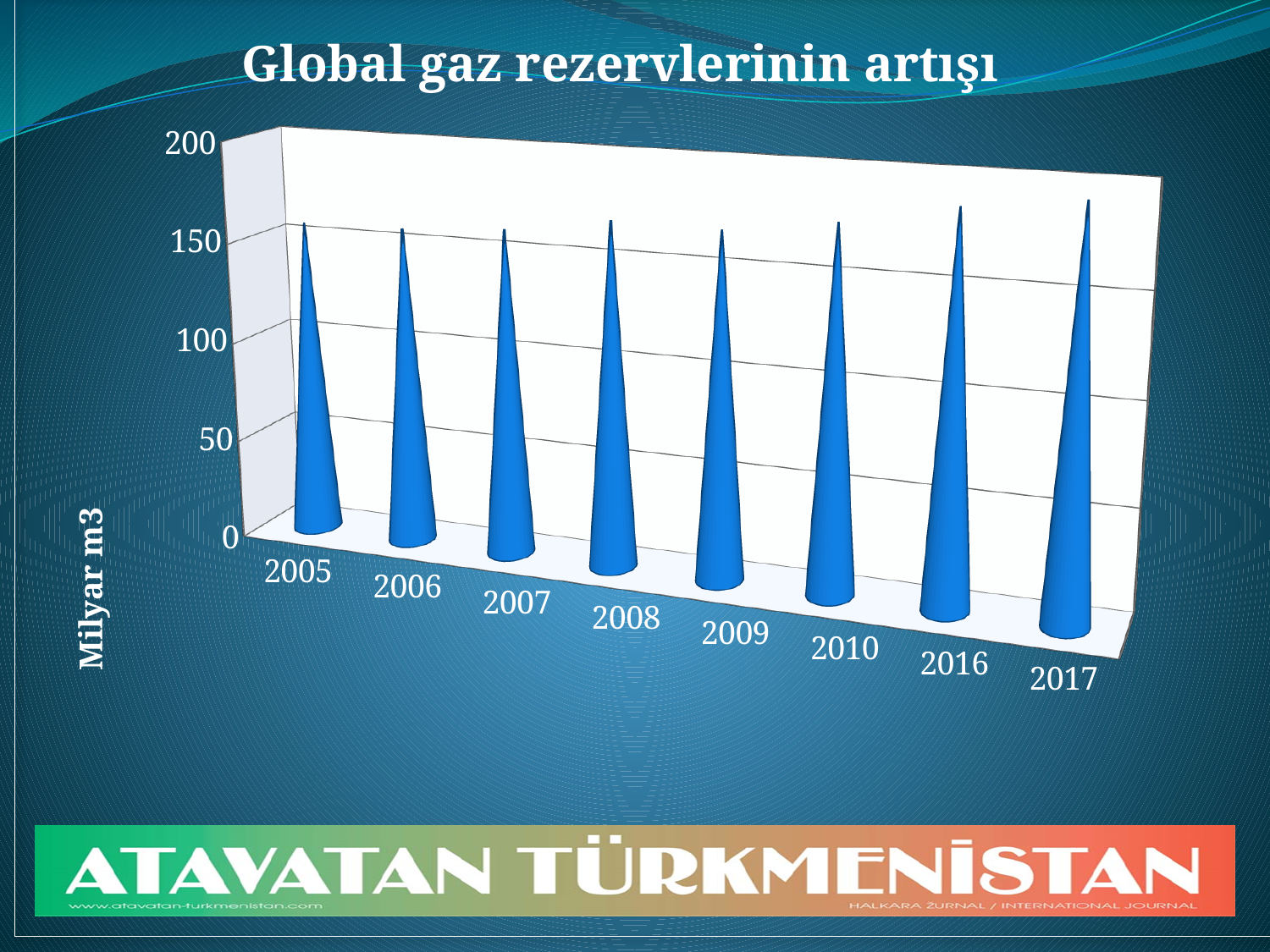
Which is larger, the value for 2017 or the value for 2005? 2017 Is the value for 2016 greater or less than 150? greater Is the value for 2009 greater or less than 200? less Is the value for 2017 greater or less than 150? greater What is the title of the chart? Global gaz rezervlerinin artışı What kind of chart is shown on the slide? bar chart Which is larger, the value for 2016 or the value for 2007? 2016 Do the values generally rise or fall from 2005 to 2017? rise How many years are shown on the x axis of the chart? 8 Which year has the highest value in the chart? 2017 What is the label on the vertical axis of the chart? Milyar m3